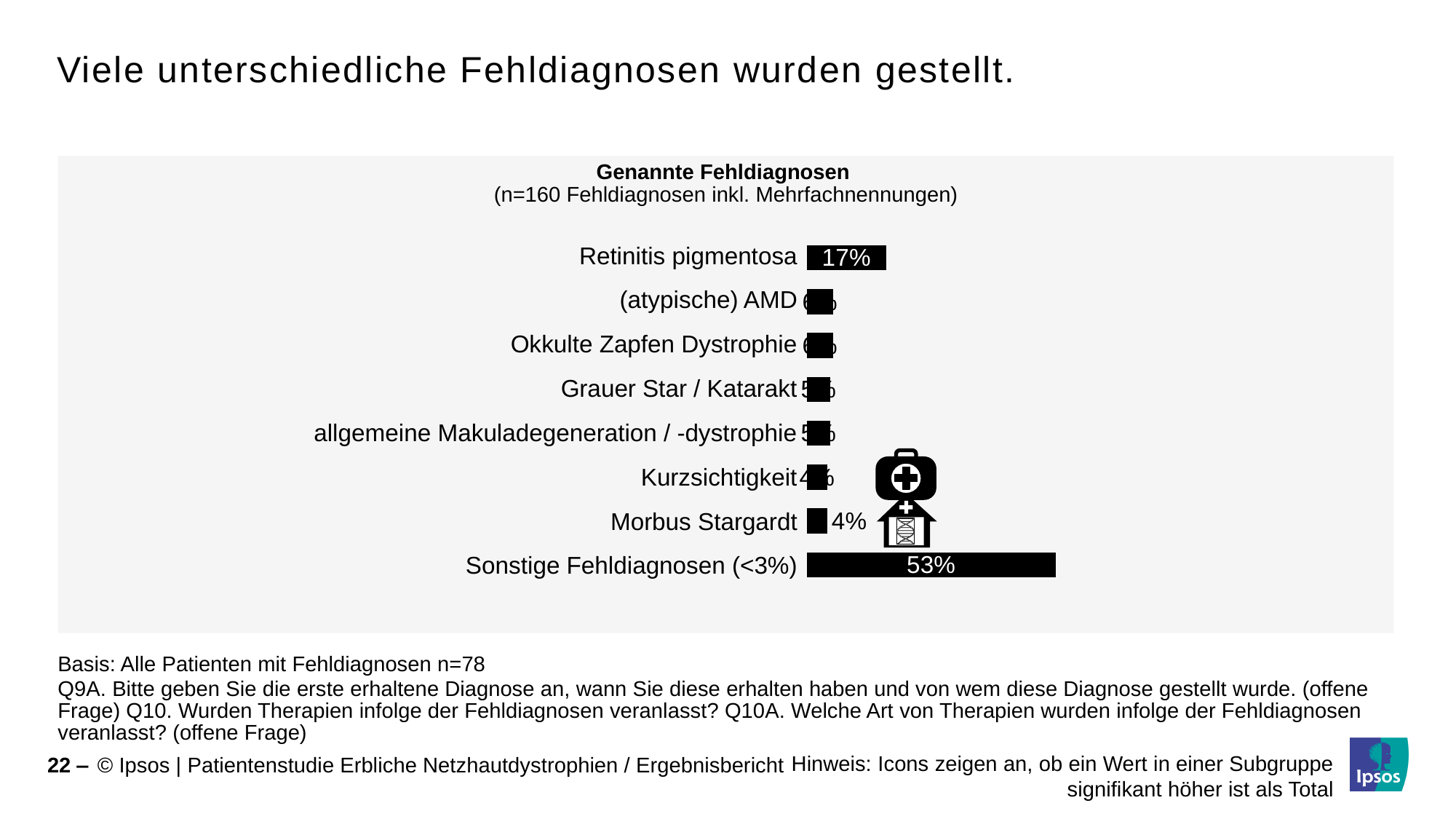
What is the difference between the value for Sonstige Fehldiagnosen (<3%) and the value for Retinitis pigmentosa? 36 percentage points Which is larger, the value for Sonstige Fehldiagnosen (<3%) or the value for Retinitis pigmentosa? Sonstige Fehldiagnosen (<3%) What is the value for Retinitis pigmentosa? 17% Which category has the highest value? Sonstige Fehldiagnosen (<3%) What is the value for Morbus Stargardt? 4% What is the title of the chart? Genannte Fehldiagnosen According to the chart subtitle, how many Fehldiagnosen (including multiple mentions) does the chart cover? n=160 What is the difference between the value for Retinitis pigmentosa and the value for Morbus Stargardt? 13 percentage points How many categories does the chart show? 8 What kind of chart is shown on the slide? bar chart What is the value for Sonstige Fehldiagnosen (<3%)? 53% Which is larger, the value for Retinitis pigmentosa or the value for Morbus Stargardt? Retinitis pigmentosa